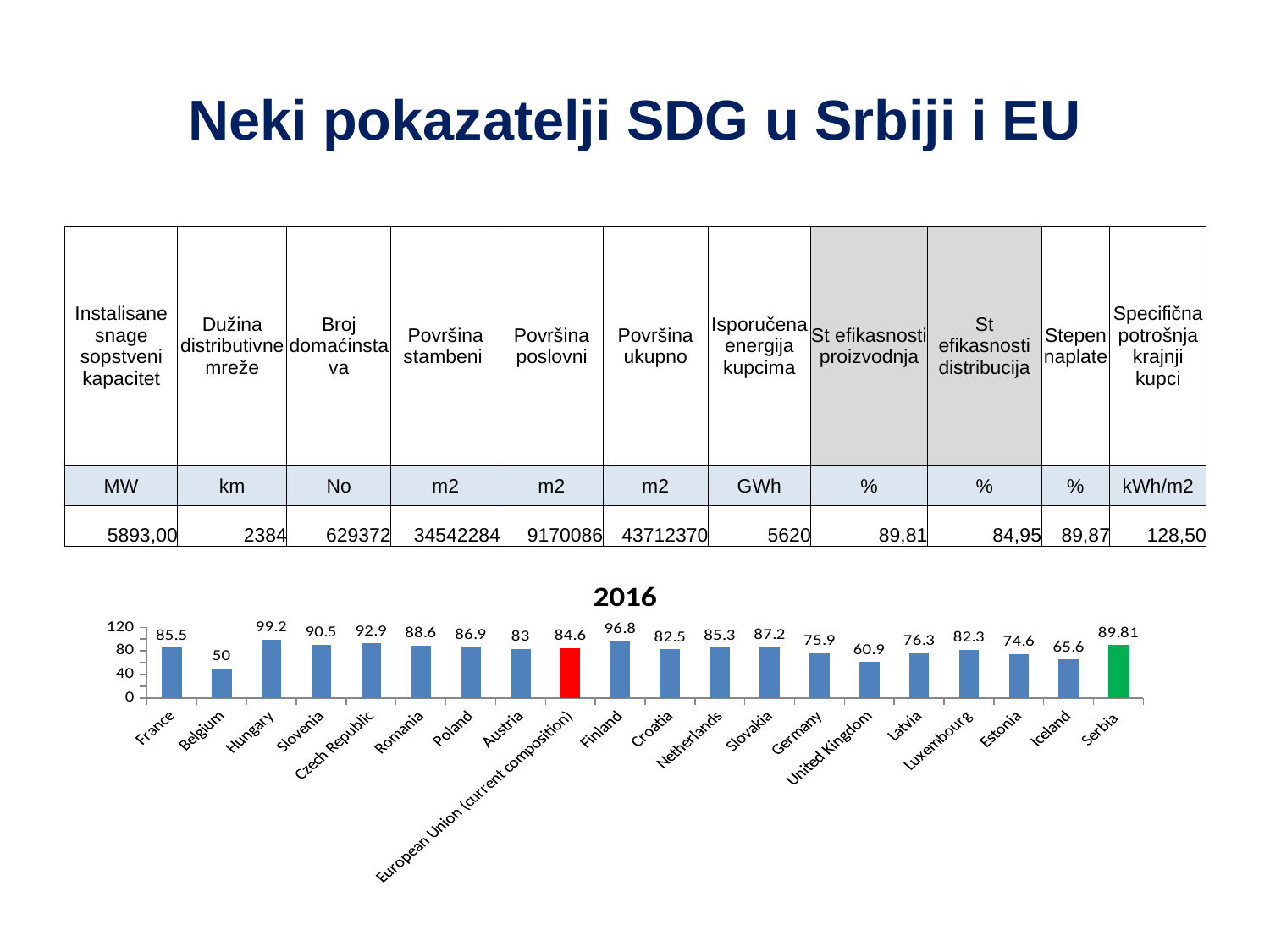
Which country has the lowest value in the 2016 chart? Belgium In the 2016 chart, what is the difference between the values for Finland and Iceland? 31.2 How many countries or regions are shown in the 2016 chart? 20 What type of chart is the 2016 chart? bar chart In the 2016 chart, what is the difference between the values for Hungary and Belgium? 49.2 What is the value for Serbia in the 2016 chart? 89.81 Which country has the highest value in the 2016 chart? Hungary In the 2016 chart, which bar is coloured red? European Union (current composition) What is the value for European Union (current composition) in the 2016 chart? 84.6 In the 2016 chart, which is larger, the value for Germany or the value for Latvia? Latvia What is the value for Belgium in the 2016 chart? 50 In the 2016 chart, is the value for United Kingdom greater or less than 80? less